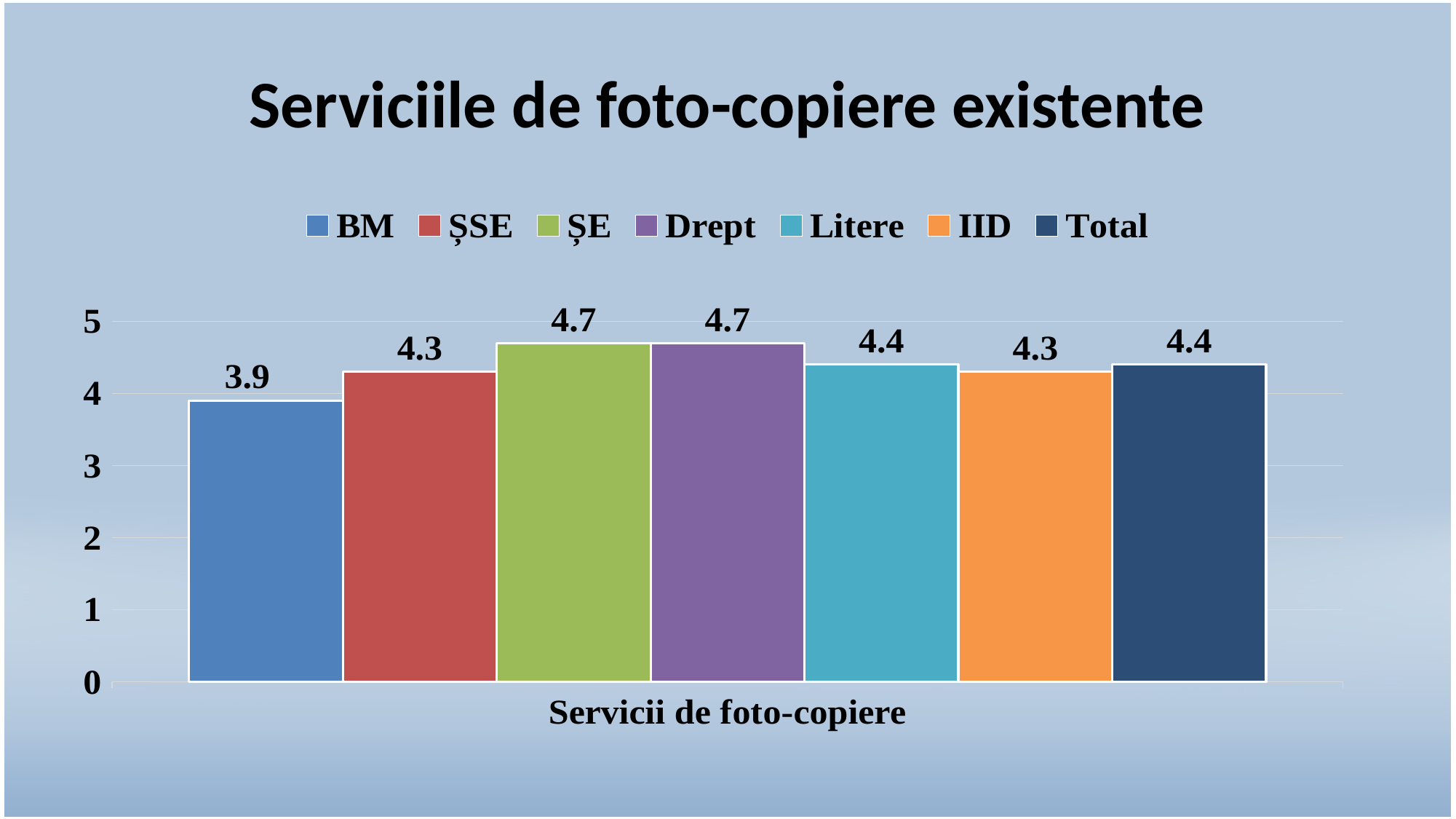
What is the value for IID? 4.3 Which series has the lowest value? BM How many series does the legend list? 7 What is the value for BM? 3.9 What is the difference between the values for ȘE and BM? 0.8 Which is larger, the value for ȘSE or the value for Litere? Litere What is the title of the chart? Serviciile de foto-copiere existente Is the value for BM greater or less than 4? less What is the value for Drept? 4.7 What is the value for Total? 4.4 What kind of chart is shown on the slide? bar chart What is the value for Litere? 4.4